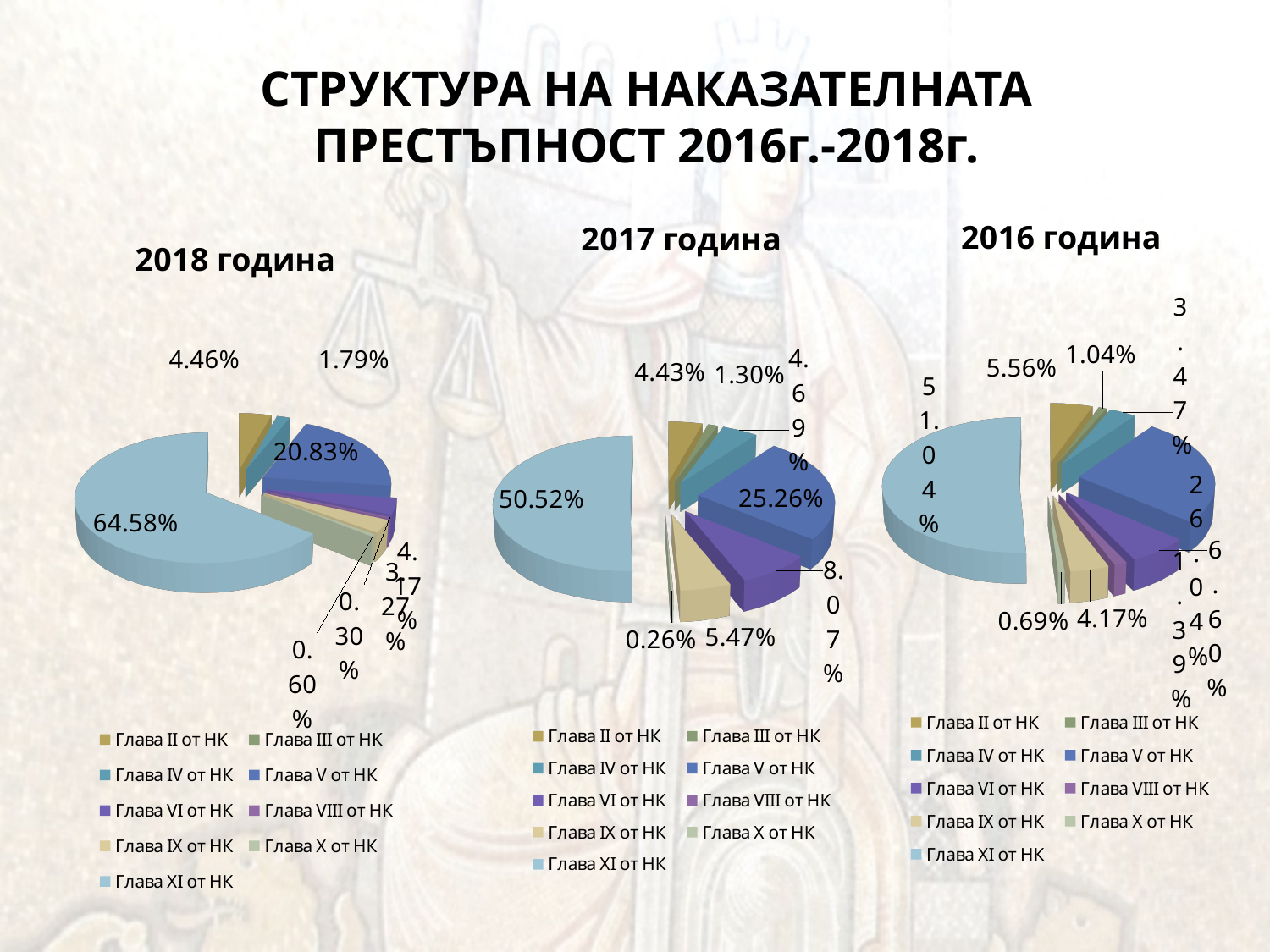
In the '2018 година' chart, what is the share of Глава V от НК? 20.83% In the '2016 година' chart, what is the value of the largest slice? 51.04% Which is larger: the largest slice in the '2018 година' chart or the largest slice in the '2017 година' chart? 2018 година (64.58%) What kind of charts are shown on the slide? Pie charts What is the difference between the largest slice in the '2018 година' chart (64.58%) and the largest slice in the '2017 година' chart (50.52%)? 14.06 percentage points How many pie charts are on the slide? 3 In the '2018 година' chart, what is the value of the largest slice? 64.58% In the '2018 година' chart, which category has the largest share? Глава XI от НК What is the title of the slide? СТРУКТУРА НА НАКАЗАТЕЛНАТА ПРЕСТЪПНОСТ 2016г.-2018г. In the '2017 година' chart, what is the share of Глава V от НК? 25.26% How many entries does the legend of the '2017 година' chart list? 9